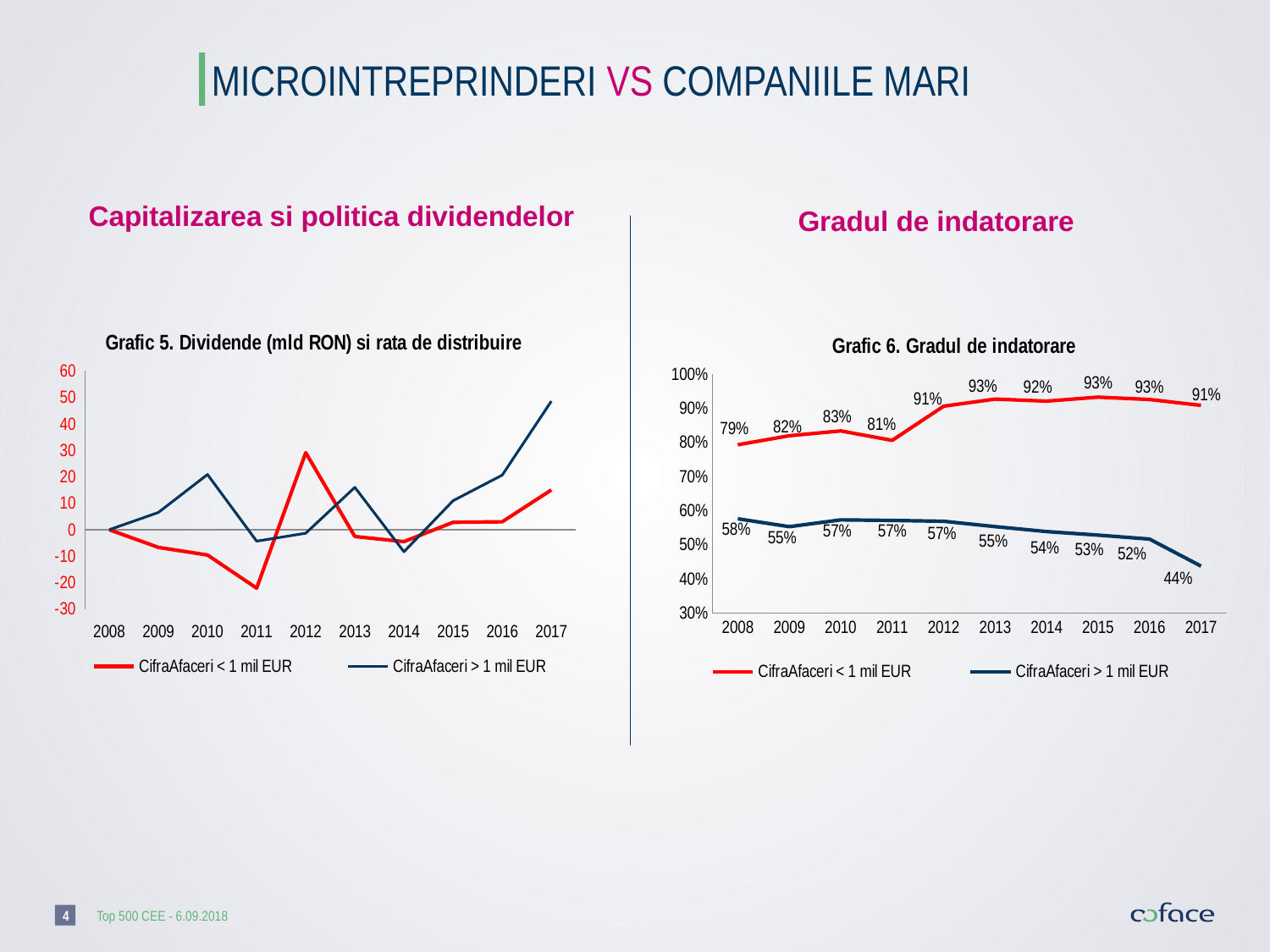
In Grafic 5, is the value for CifraAfaceri < 1 mil EUR in 2011 greater or less than -10? less In Grafic 6, does the CifraAfaceri > 1 mil EUR series generally rise or fall from 2008 to 2017? fall In Grafic 6, what is the value for CifraAfaceri > 1 mil EUR in 2017? 44% In Grafic 5, is the value for CifraAfaceri < 1 mil EUR in 2012 greater or less than 20? greater In Grafic 5, is the value for CifraAfaceri > 1 mil EUR in 2017 greater or less than 40? greater How many series does the legend of Grafic 5 list? 2 In Grafic 6, what is the value for CifraAfaceri > 1 mil EUR in 2008? 58% In Grafic 6, in which year is the CifraAfaceri > 1 mil EUR series at its lowest? 2017 In Grafic 6, what is the value for CifraAfaceri < 1 mil EUR in 2013? 93% In Grafic 6, what is the difference between the two series in 2017? 47% In Grafic 6, what is the difference between the CifraAfaceri < 1 mil EUR values in 2012 and 2011? 10% In Grafic 6, in which year is the CifraAfaceri < 1 mil EUR series at its lowest? 2008